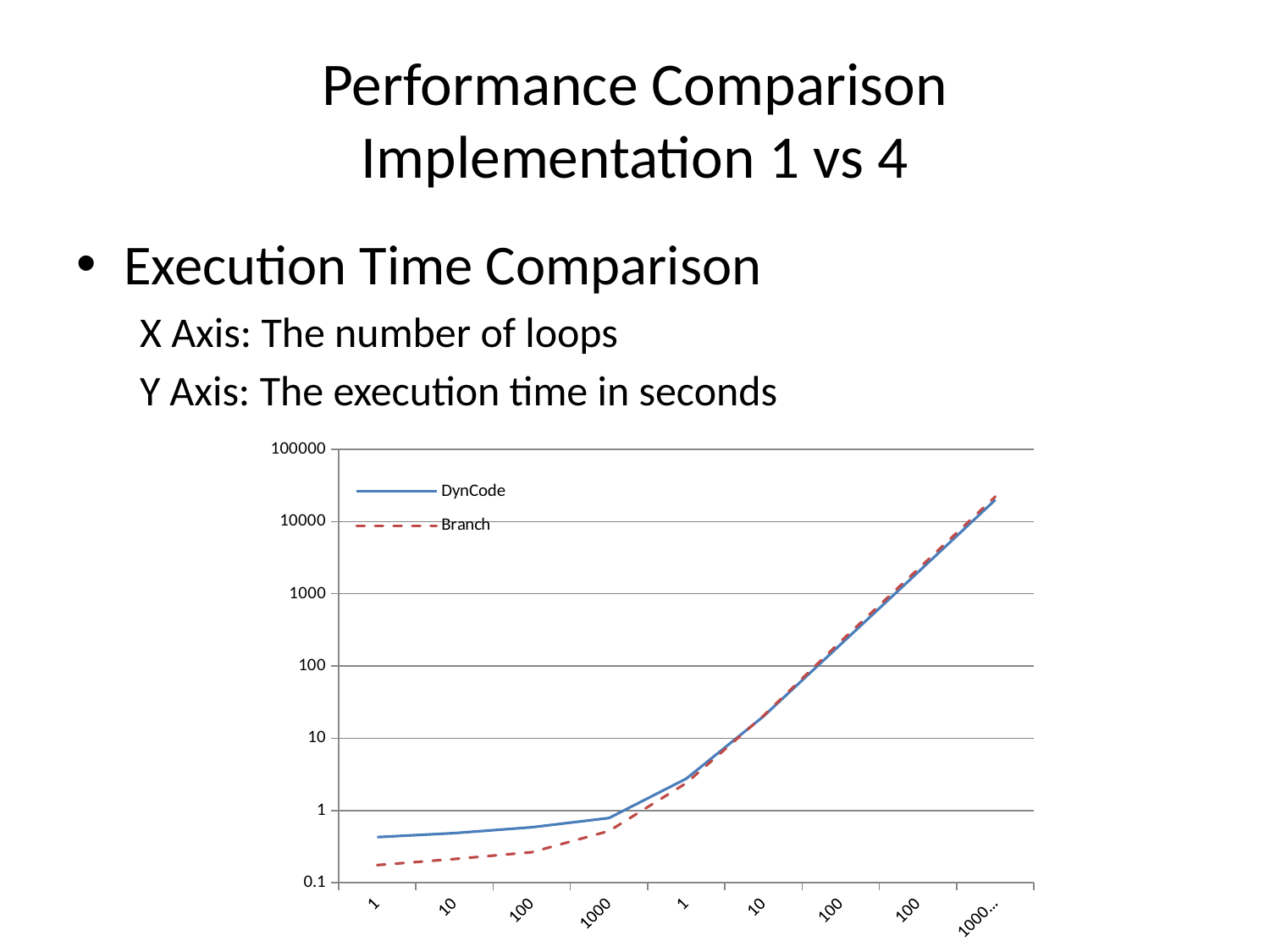
Is the value of Branch at the leftmost x-axis point (1) greater or less than 1? less How many tick labels are shown along the x axis of the chart? 9 Is the value of Branch at the fourth x-axis point (1000) greater or less than 1? less Do the values of the DynCode series rise or fall as you move along the x axis from left to right? rise Do the values of the Branch series rise or fall along the x axis? rise Which series is drawn with a dashed line in the chart? Branch What kind of chart is shown on the slide? line chart What are the two series named in the chart's legend? DynCode and Branch Is the value of DynCode at the rightmost x-axis point greater or less than 10000? greater How many series does the chart's legend list? 2 At the leftmost x-axis point (1), which series has the larger value, DynCode or Branch? DynCode